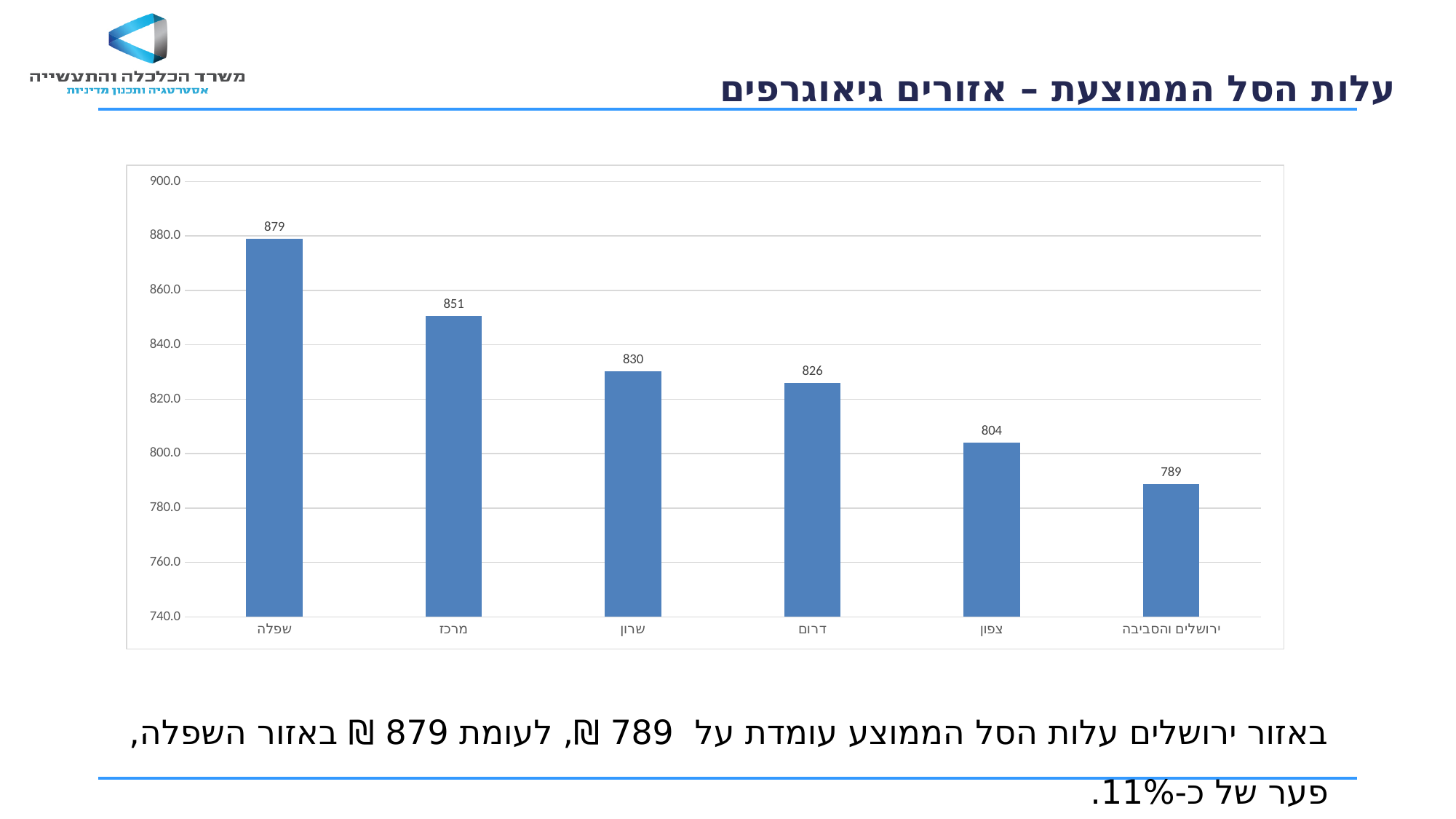
What is the value for ירושלים והסביבה? 789 Which category has the lowest value? ירושלים והסביבה What kind of chart is shown on the slide? Bar chart What is the value for שפלה? 879 How many categories are shown in the chart? 6 Do the values rise or fall from left to right along the x axis? Fall What is the value for מרכז? 851 Which category has the highest value? שפלה What is the difference between the values for שפלה and ירושלים והסביבה? 90 What is the difference between the values for שרון and דרום? 4 What is the value for צפון? 804 Which is larger, the value for מרכז or the value for צפון? מרכז